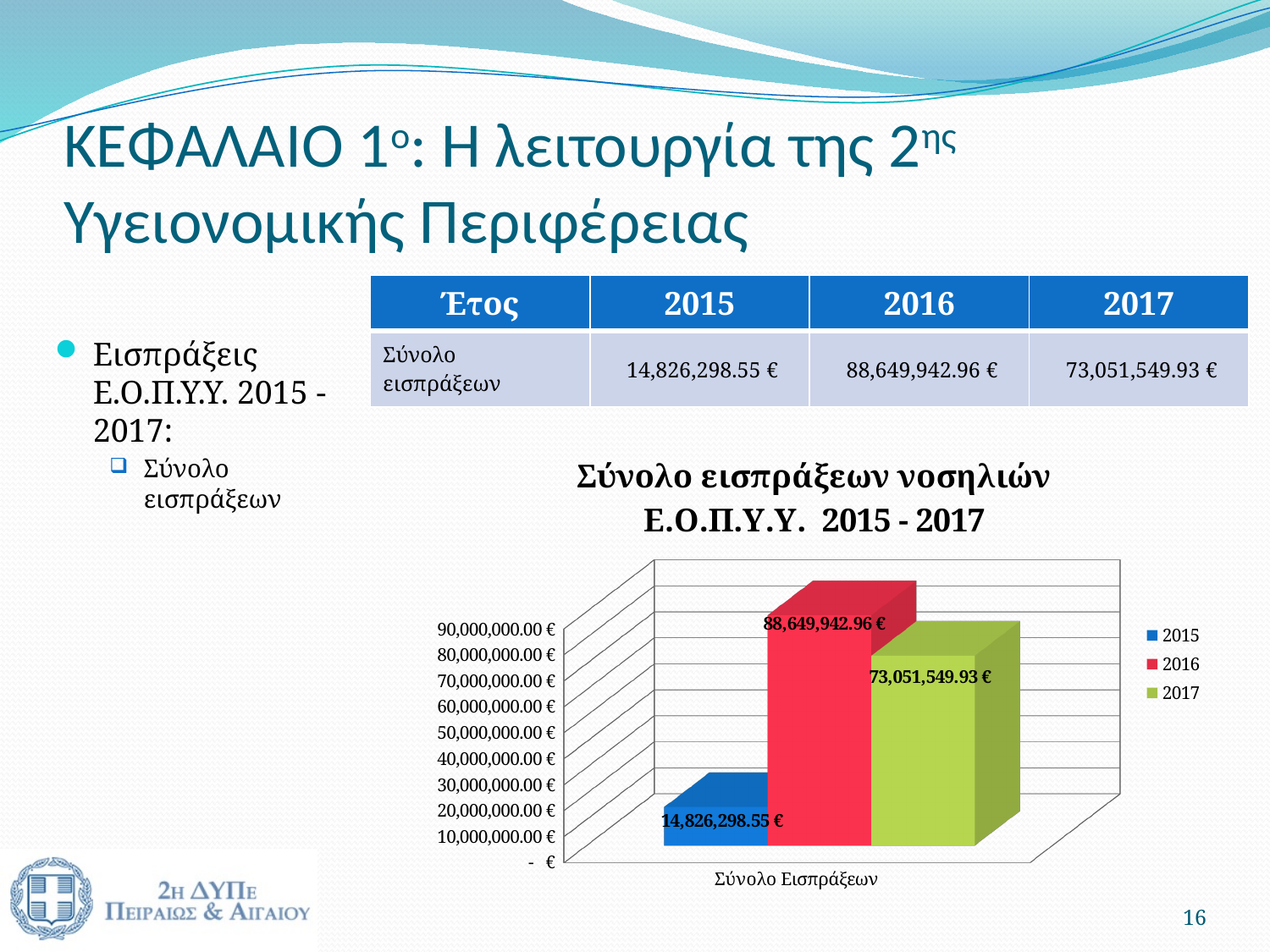
Which year has the lowest value in the chart? 2015 What is the value for 2016 in the chart? 88,649,942.96 € What is the title of the chart? Σύνολο εισπράξεων νοσηλιών Ε.Ο.Π.Υ.Υ. 2015 - 2017 Which year has the highest value in the chart? 2016 How many series does the chart legend list? 3 What is the value for 2017 in the chart? 73,051,549.93 € Which is larger in the chart, the value for 2015 or the value for 2017? 2017 Is the value for 2015 greater or less than 20,000,000.00 €? less What is the difference between the 2017 and 2015 values in the chart? 58,225,251.38 € What is the value for 2015 in the chart? 14,826,298.55 € What is the difference between the 2016 and 2017 values in the chart? 15,598,393.03 € What type of chart is shown on the slide? bar chart